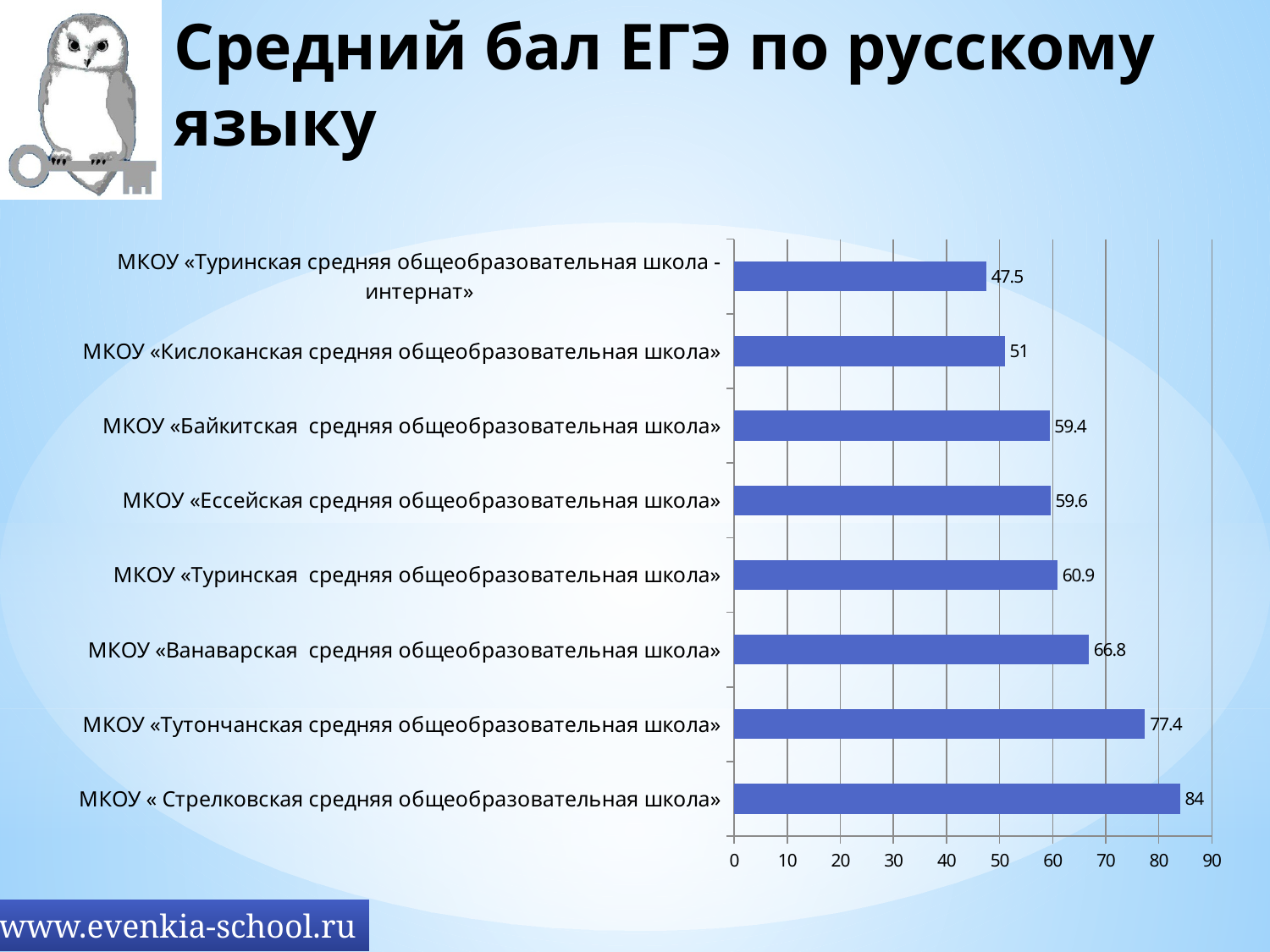
Which school has the lowest average score on the chart? МКОУ «Туринская средняя общеобразовательная школа - интернат» What is the value shown for МКОУ «Тутончанская средняя общеобразовательная школа»? 77.4 What is the difference between the scores of МКОУ «Стрелковская средняя общеобразовательная школа» and МКОУ «Тутончанская средняя общеобразовательная школа»? 6.6 What is the value shown for МКОУ «Ванаварская средняя общеобразовательная школа»? 66.8 Which school has the highest average score on the chart? МКОУ « Стрелковская средняя общеобразовательная школа» What is the value shown for МКОУ «Туринская средняя общеобразовательная школа - интернат»? 47.5 How many schools are shown on the chart? 8 What type of chart is shown on the slide? Bar chart What is the title of the slide? Средний бал ЕГЭ по русскому языку What is the difference between the scores of МКОУ «Кислоканская средняя общеобразовательная школа» and МКОУ «Туринская средняя общеобразовательная школа - интернат»? 3.5 Which has a higher score: МКОУ «Ванаварская средняя общеобразовательная школа» or МКОУ «Туринская средняя общеобразовательная школа»? МКОУ «Ванаварская средняя общеобразовательная школа» What is the average Russian language exam score for МКОУ «Стрелковская средняя общеобразовательная школа»? 84